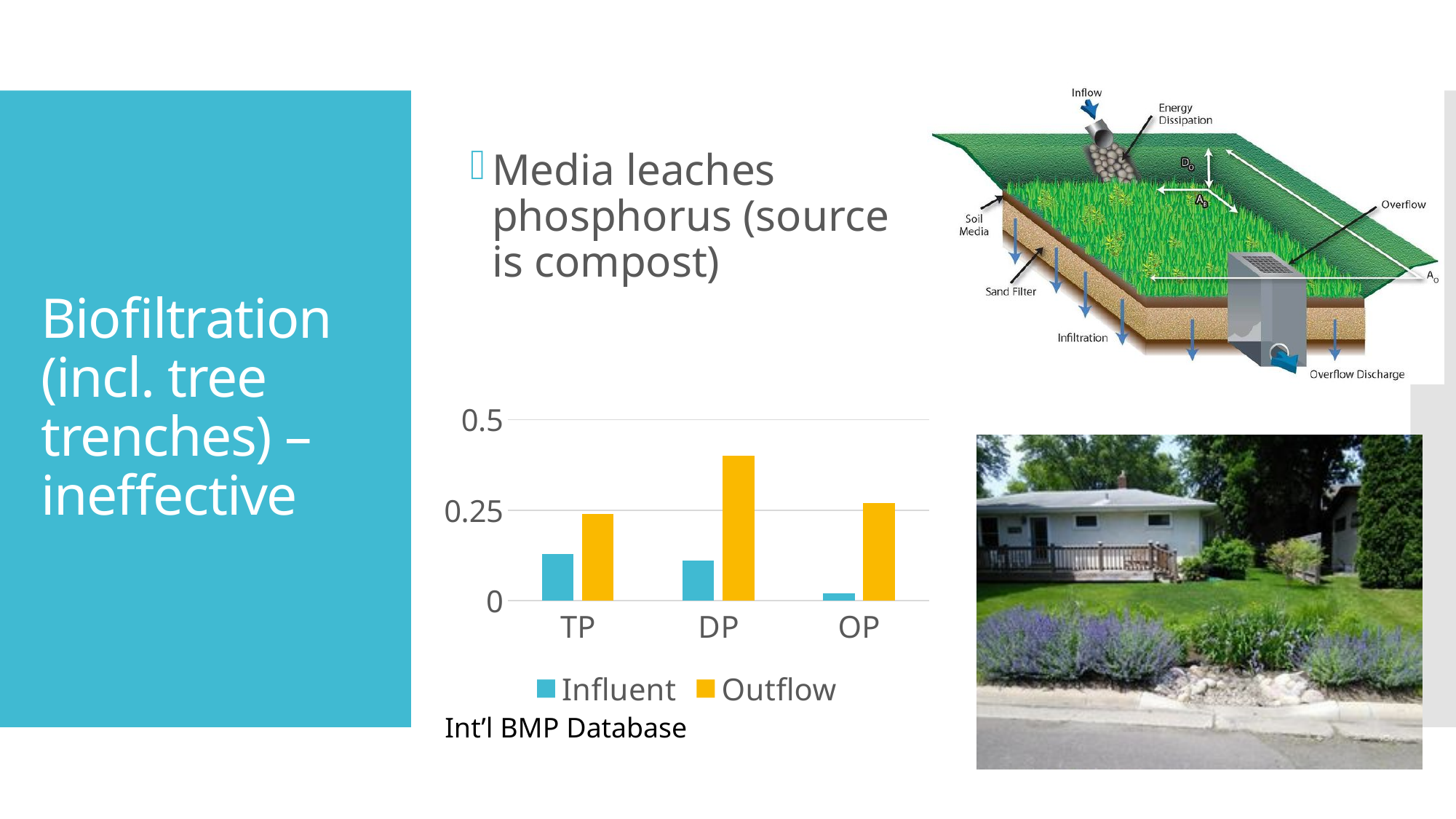
Which category has the lowest Influent value in the bar chart? OP Which category has the highest Outflow value in the bar chart? DP What kind of chart is shown on the slide? bar chart What source is cited below the bar chart? Int'l BMP Database Is the Outflow value for DP greater or less than 0.5? less For OP, which is larger: the Influent value or the Outflow value? Outflow How many series does the legend of the bar chart list? 2 For TP, which is larger: the Influent value or the Outflow value? Outflow Is the Influent value for TP greater or less than 0.25? less How many categories are shown on the x axis of the bar chart? 3 Is the Outflow value for DP greater or less than 0.25? greater What are the two series named in the legend of the bar chart? Influent and Outflow